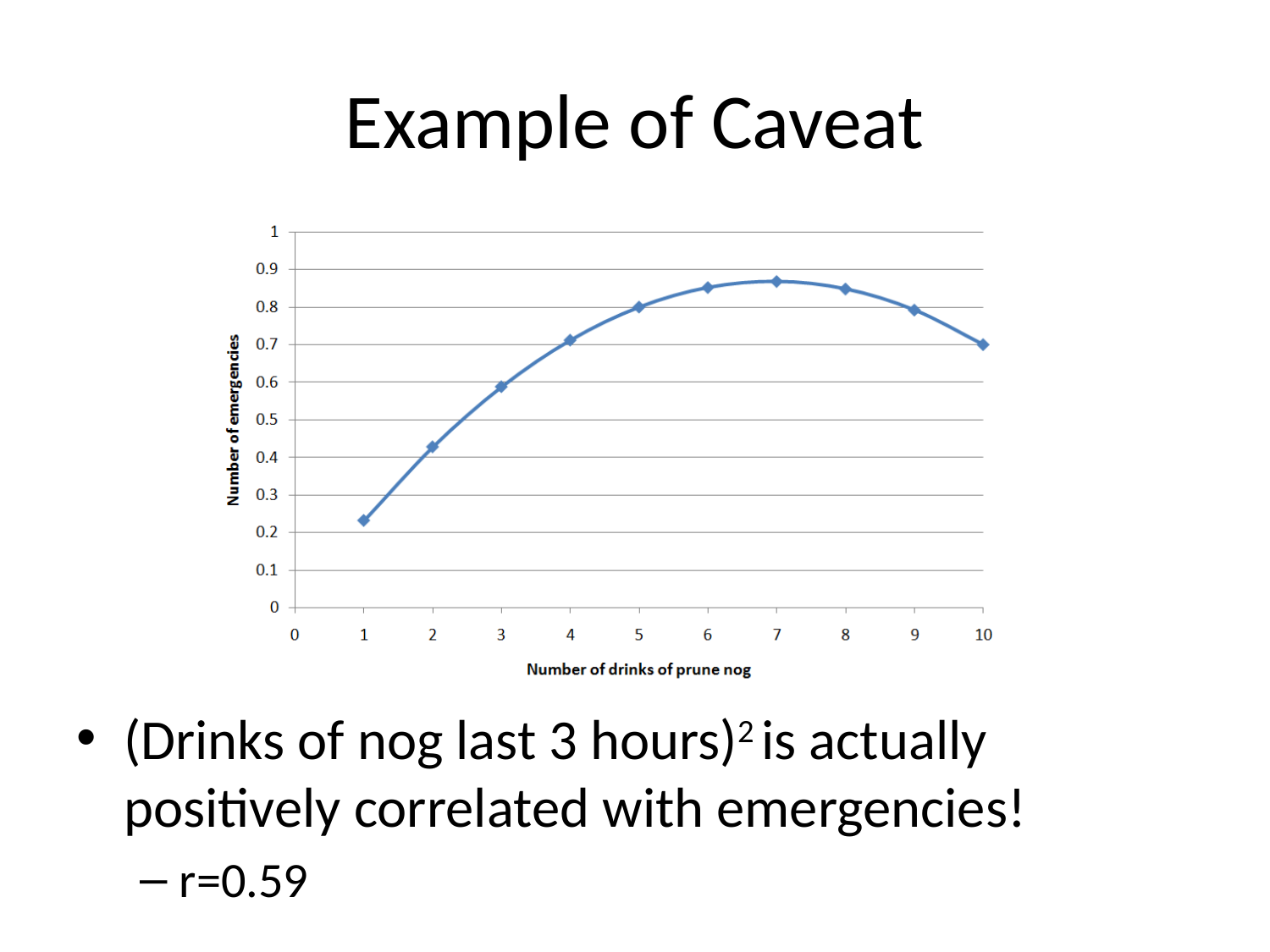
Which has a higher number of emergencies: 3 drinks or 8 drinks of prune nog? 8 drinks Is the value for 10 drinks of prune nog greater or less than 0.6? greater What kind of chart is shown on the slide? line chart What is the title of the x axis? Number of drinks of prune nog Do the values rise or fall as the number of drinks increases from 7 to 10? fall At which number of drinks of prune nog is the number of emergencies lowest? 1 How many data points are plotted on the chart? 10 Is the value for 2 drinks of prune nog greater or less than 0.5? less Which has a higher number of emergencies: 1 drink or 10 drinks of prune nog? 10 drinks Is the value for 3 drinks of prune nog greater or less than 0.5? greater